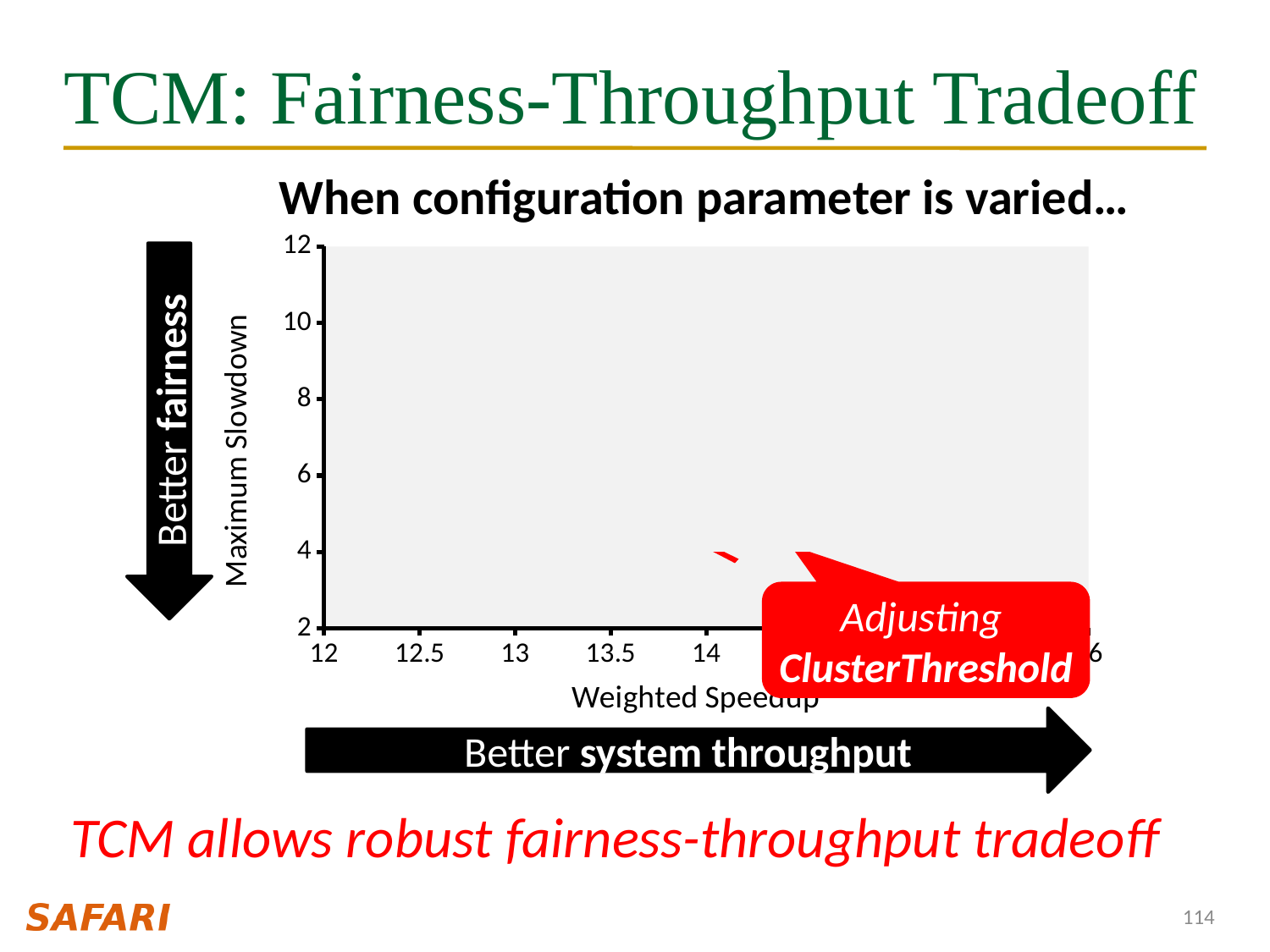
What is the lowest tick value shown on the x axis of the chart? 12 Is the Maximum Slowdown of the visible red data mark near Weighted Speedup 14 greater or less than 2? greater Is the Maximum Slowdown of the visible red data mark near Weighted Speedup 14 greater or less than 6? less What is the label of the y axis of the chart? Maximum Slowdown What is the lowest tick value shown on the y axis of the chart? 2 What is the label of the x axis of the chart? Weighted Speedup What is the highest tick value shown on the y axis of the chart? 12